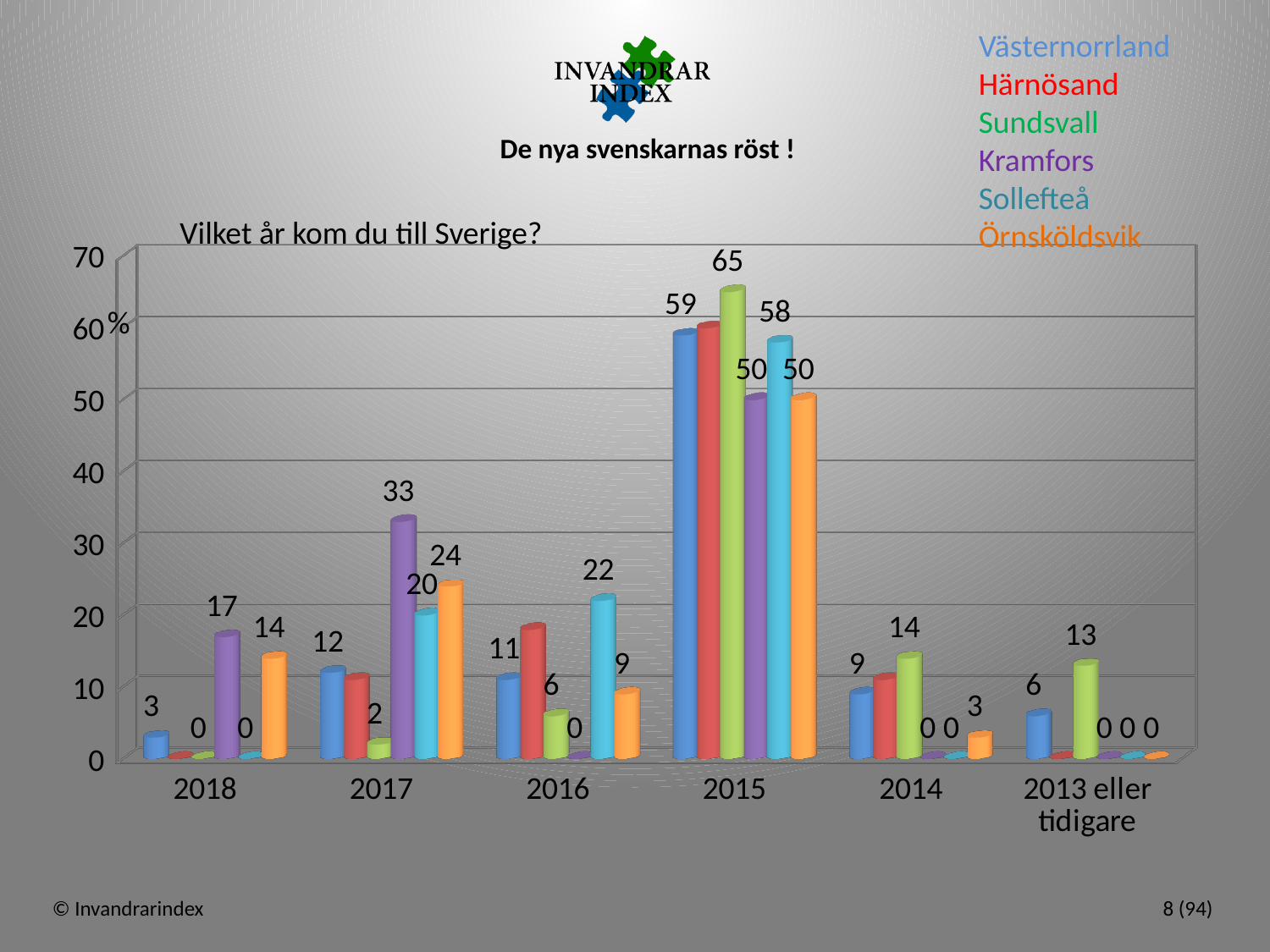
What is the value for Kramfors in 2017? 33 What kind of chart is shown on the slide? bar chart Which series has the highest value in 2015? Sundsvall What is the value for Sundsvall in 2015? 65 Which is larger in 2017, the value for Kramfors or the value for Örnsköldsvik? Kramfors Is the value for Härnösand in 2016 greater or less than 10? greater What is the difference between the Sundsvall and Kramfors values in 2015? 15 How many series does the legend list? 6 How many year categories are shown on the x axis? 6 What is the value for Sollefteå in 2016? 22 Which series has the highest value in 2017? Kramfors What is the value for Örnsköldsvik in 2018? 14